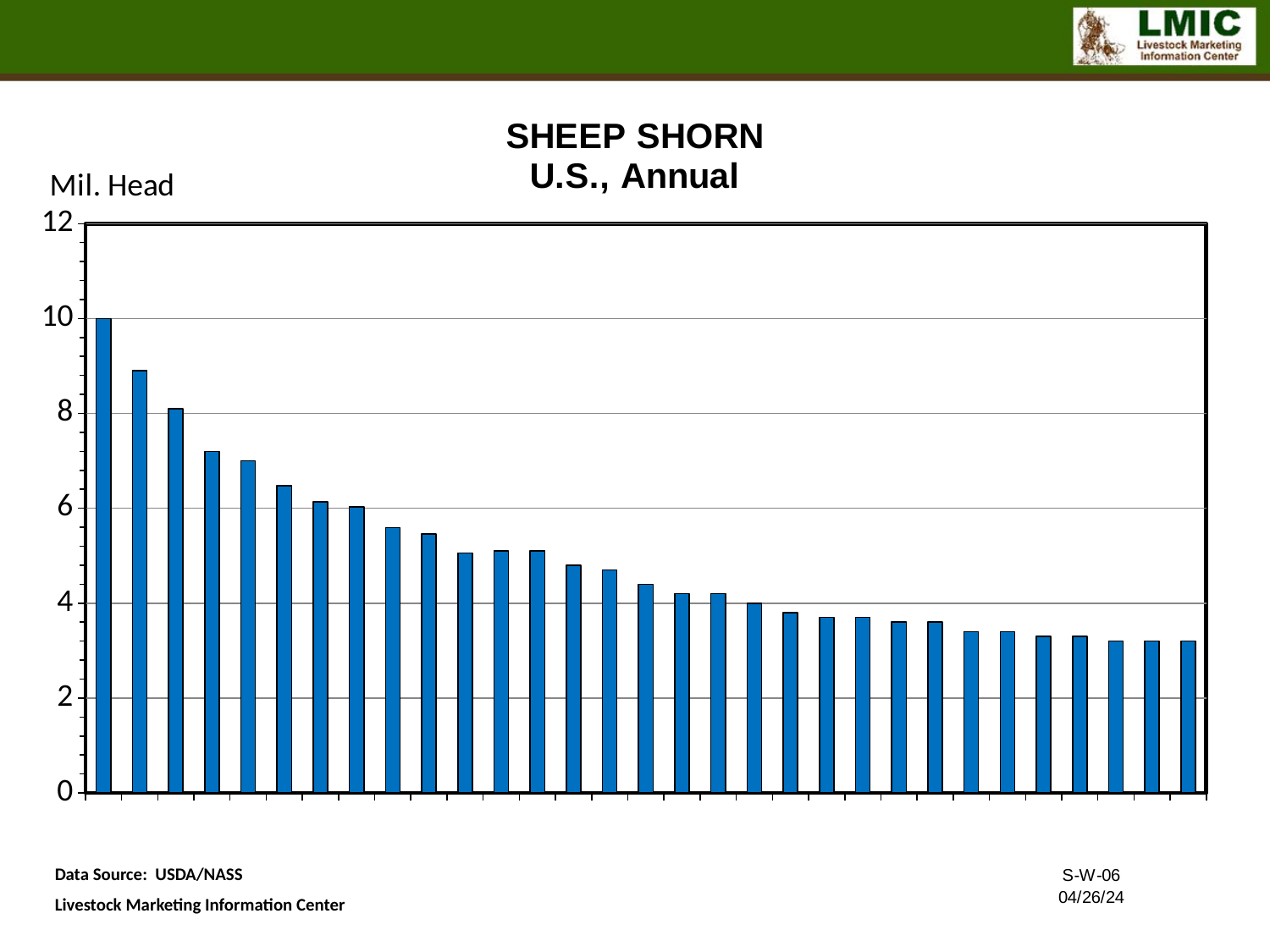
What is the highest value shown on the vertical axis? 12 Is the value of the second bar from the left greater or less than 8? greater Is the value of the rightmost bar greater or less than 2? greater What kind of chart is shown on the slide? bar chart What is the title of the chart? SHEEP SHORN U.S., Annual Do the values generally rise or fall from left to right along the x axis? fall Which bar is the highest in the chart? the leftmost bar What unit is shown on the vertical axis of the chart? Mil. Head Which is larger, the leftmost bar or the rightmost bar? the leftmost bar Is the value of the rightmost bar greater or less than 4? less How many bars are plotted in the chart? 31